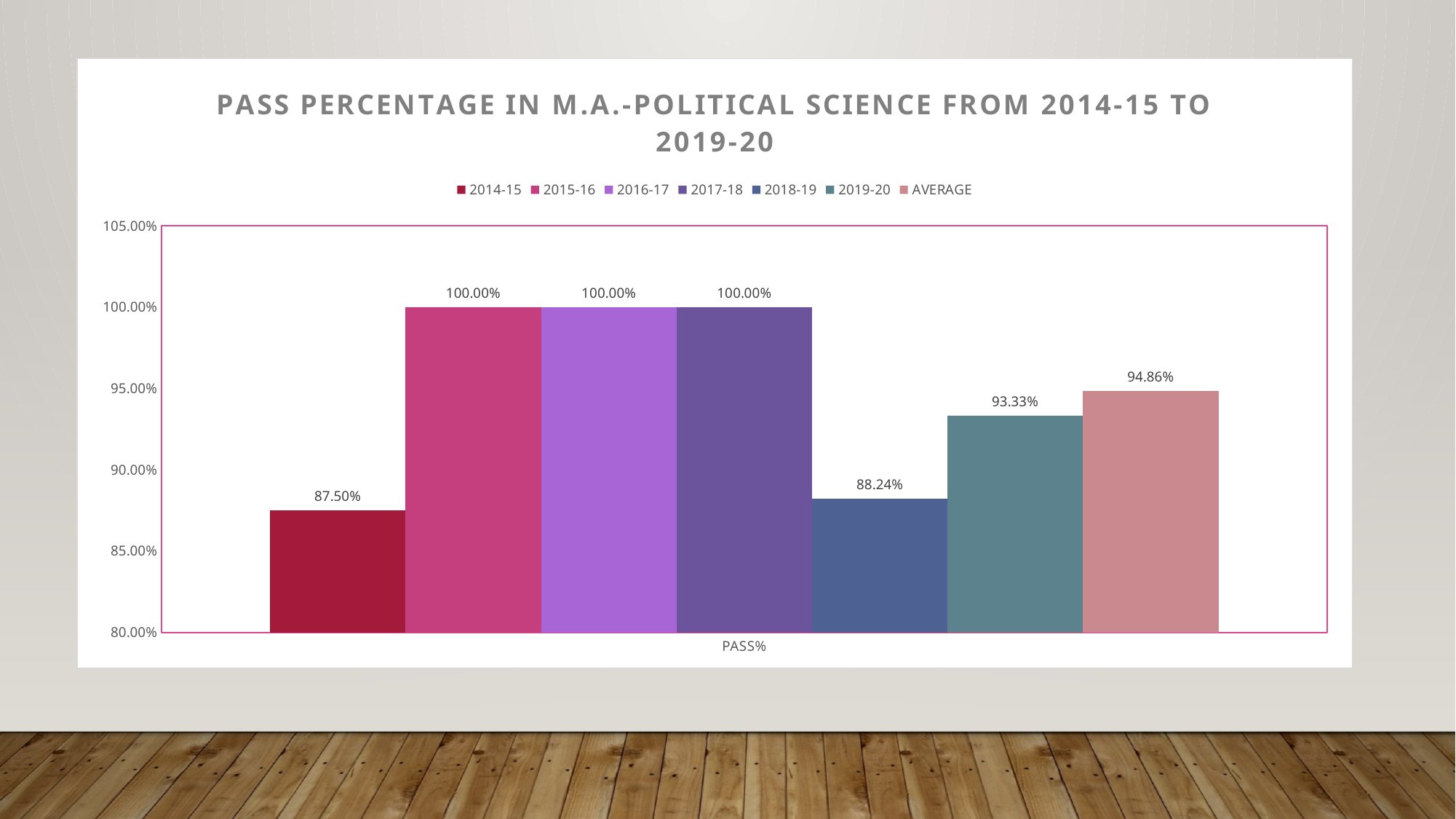
Is the value for 2018-19 greater or less than 90.00%? less What is the pass percentage for 2019-20? 93.33% What kind of chart is shown on the slide? bar chart What is the difference between the pass percentage for 2019-20 and 2014-15? 5.83% What is the value shown for AVERAGE? 94.86% How many series have a pass percentage of 100.00%? 3 What is the pass percentage for 2018-19? 88.24% What is the pass percentage for 2014-15? 87.50% How many series does the legend list? 7 Which year has the lowest pass percentage? 2014-15 What is the title of the chart? PASS PERCENTAGE IN M.A.-POLITICAL SCIENCE FROM 2014-15 TO 2019-20 Which is larger, the pass percentage for 2018-19 or 2019-20? 2019-20